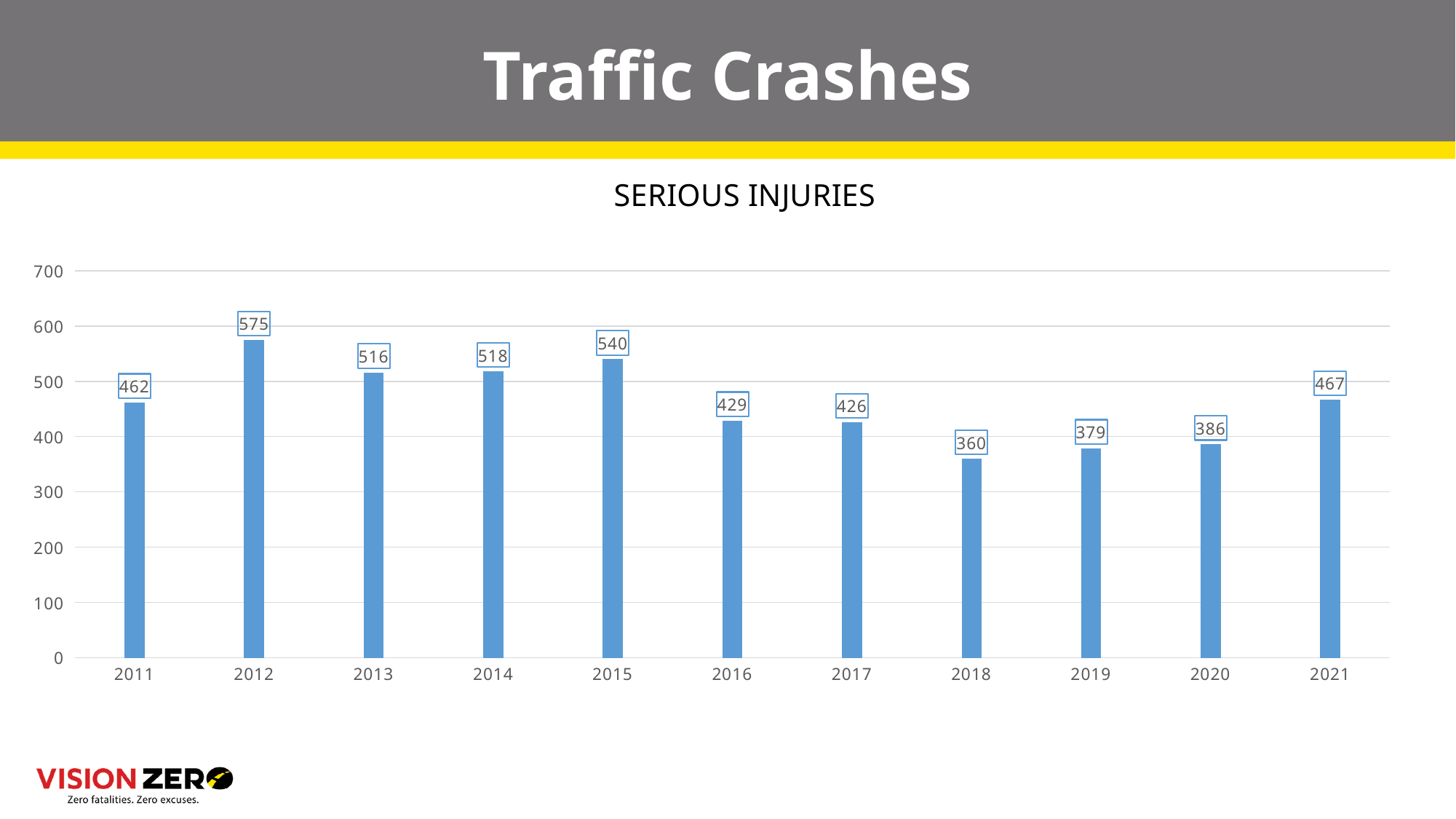
What is the difference between the values for 2015 and 2016? 111 What is the value for 2012? 575 Which is larger, the value for 2011 or the value for 2021? 2021 Which year has the highest number of serious injuries? 2012 What is the value for 2021? 467 Is the value for 2019 greater or less than 400? less How many years are shown on the x axis? 11 Which year has the lowest number of serious injuries? 2018 What is the difference between the values for 2012 and 2018? 215 What is the title of the chart? SERIOUS INJURIES What is the value for 2018? 360 What kind of chart is shown on the slide? bar chart